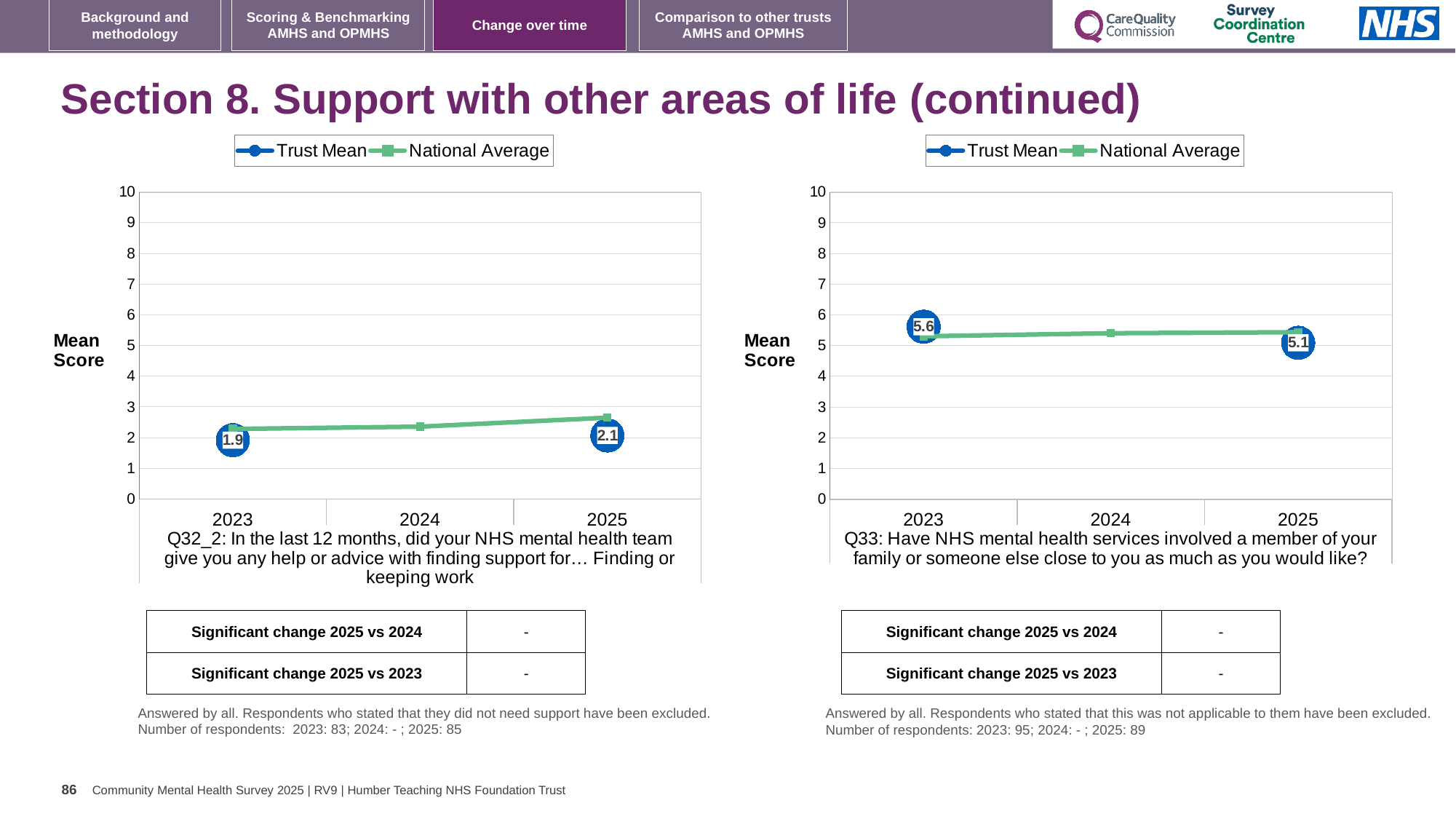
In the left chart (Q32_2), what is the Trust Mean for 2023? 1.9 In the left chart (Q32_2), what is the difference between the Trust Mean for 2025 and 2023? 0.2 In the right chart (Q33), what is the Trust Mean for 2025? 5.1 In the left chart (Q32_2), does the Trust Mean rise or fall from 2023 to 2025? rise In the left chart (Q32_2), what is the Trust Mean for 2025? 2.1 How many series does the legend of the right chart (Q33) list? 2 In the right chart (Q33), is the National Average for 2024 greater or less than 4? greater In the left chart (Q32_2), is the National Average for 2025 greater or less than 3? less In the right chart (Q33), which year has the higher Trust Mean, 2023 or 2025? 2023 In the right chart (Q33), what is the Trust Mean for 2023? 5.6 What kind of chart is the left chart (Q32_2)? line chart In the right chart (Q33), what is the difference between the Trust Mean for 2023 and 2025? 0.5